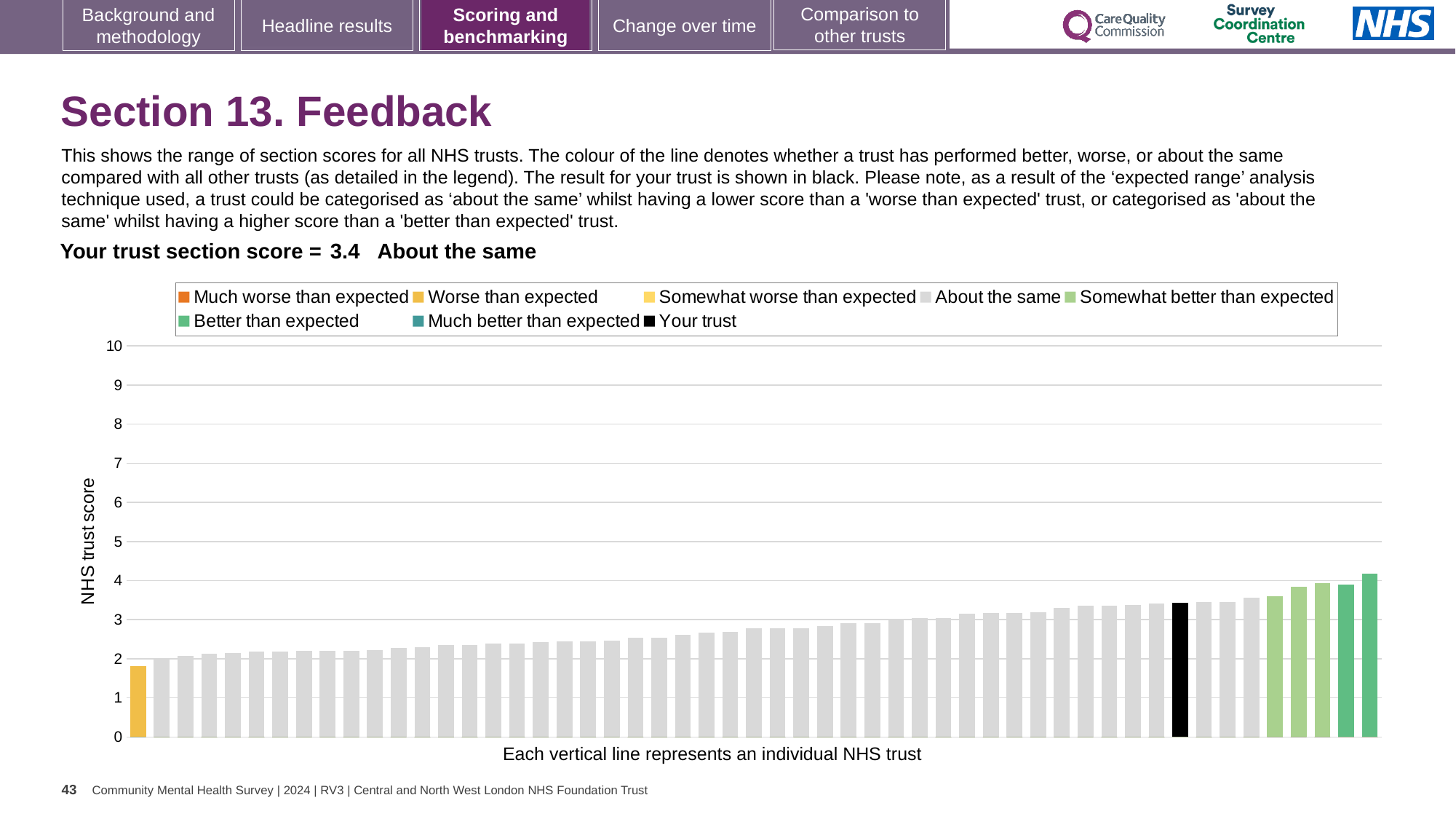
How many bars are coloured as 'Worse than expected' (yellow)? 1 How many entries does the chart legend list? 8 How is your trust's section score categorised on the slide? About the same Which is taller: the black bar for your trust or the yellow 'Worse than expected' bar? the black bar (your trust) Is the value of the black bar (your trust) greater or less than 4? less What is the section score for your trust shown on the slide? 3.4 Is the value of the leftmost (yellow) bar greater or less than 2? less What kind of chart is shown on the slide? bar chart Is the value of the black bar (your trust) greater or less than 3? greater What is the label on the vertical axis of the chart? NHS trust score Do the bar values rise or fall from left to right along the x axis? rise